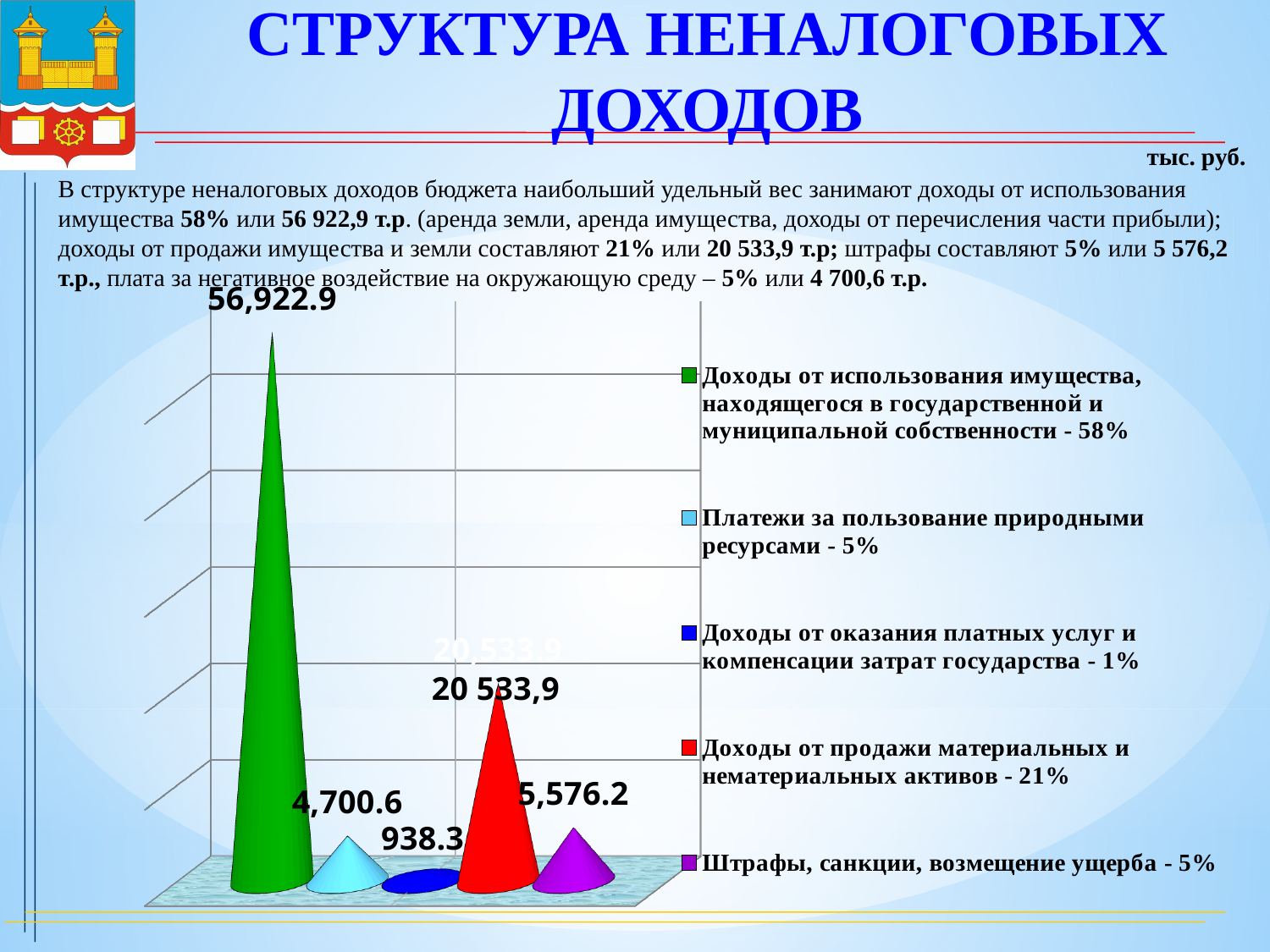
What is the value for Доходы от оказания платных услуг и компенсации затрат государства? 938.3 What is the value for Платежи за пользование природными ресурсами? 4,700.6 Which is larger: the value for Платежи за пользование природными ресурсами or the value for Доходы от оказания платных услуг и компенсации затрат государства? Платежи за пользование природными ресурсами What kind of chart is shown on the slide? Bar chart What is the difference between the values for Штрафы, санкции, возмещение ущерба and Платежи за пользование природными ресурсами? 875.6 How many series does the legend list? 5 Which series has the lowest value? Доходы от оказания платных услуг и компенсации затрат государства What is the value for Доходы от продажи материальных и нематериальных активов? 20 533,9 What is the value for Штрафы, санкции, возмещение ущерба? 5,576.2 What percentage share is shown in the legend for Доходы от продажи материальных и нематериальных активов? 21% What is the value for Доходы от использования имущества, находящегося в государственной и муниципальной собственности? 56,922.9 Which series has the highest value? Доходы от использования имущества, находящегося в государственной и муниципальной собственности